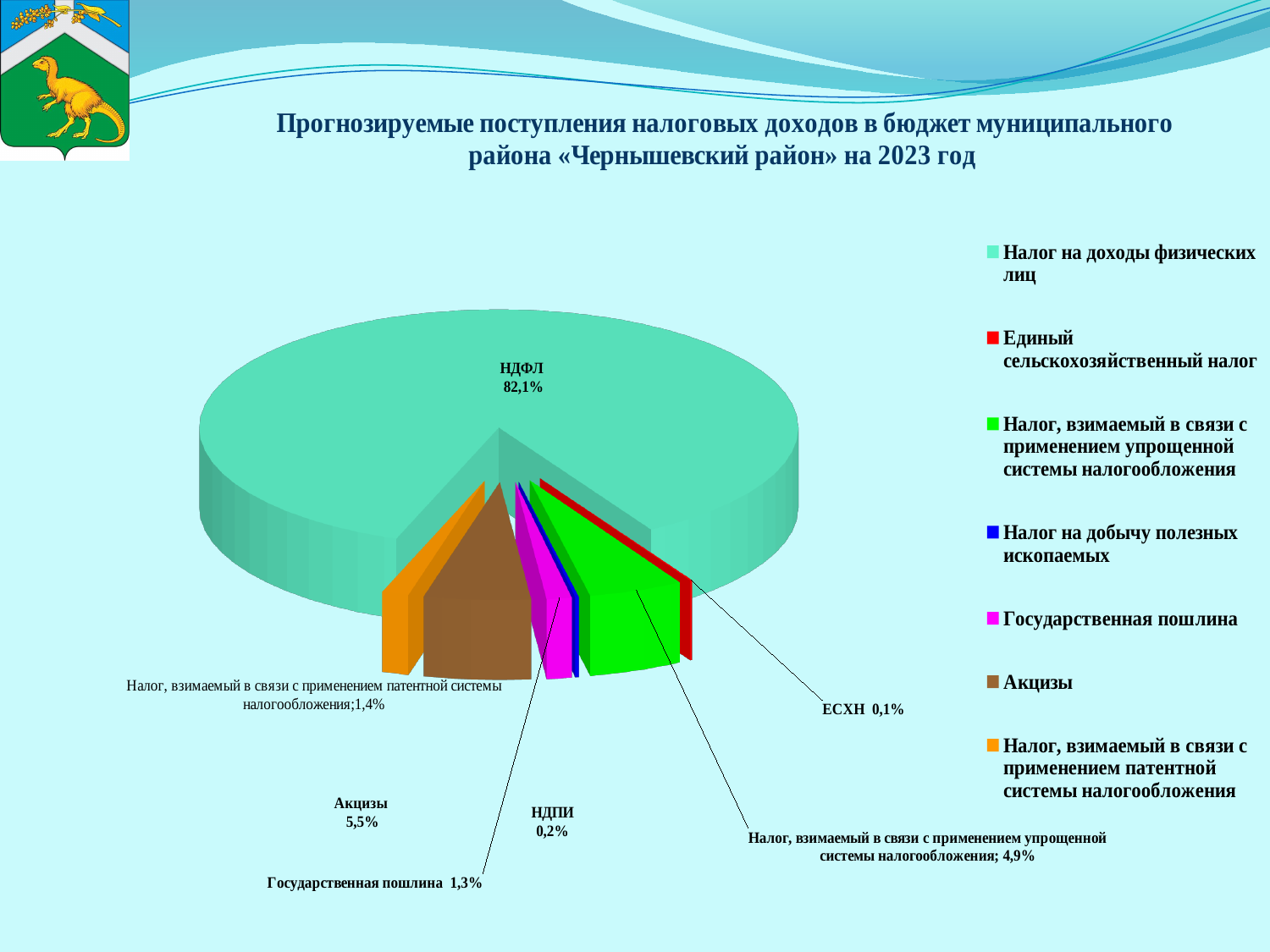
What share is shown for Государственная пошлина? 1,3% What share is shown for Налог, взимаемый в связи с применением патентной системы налогообложения? 1,4% What kind of chart is shown on the slide? pie chart Which category has the largest share of the pie? НДФЛ How many entries does the legend list? 7 Which is larger: the share for Акцизы or the share for НДПИ? Акцизы What share is shown for ЕСХН? 0,1% Which category has the smallest share of the pie? ЕСХН What share of the pie does Акцизы have? 5,5% What share of the pie does НДФЛ (Налог на доходы физических лиц) have? 82,1% What is the difference between the share for Акцизы and the share for Налог, взимаемый в связи с применением упрощенной системы налогообложения? 0,6% What share is shown for Налог, взимаемый в связи с применением упрощенной системы налогообложения? 4,9%